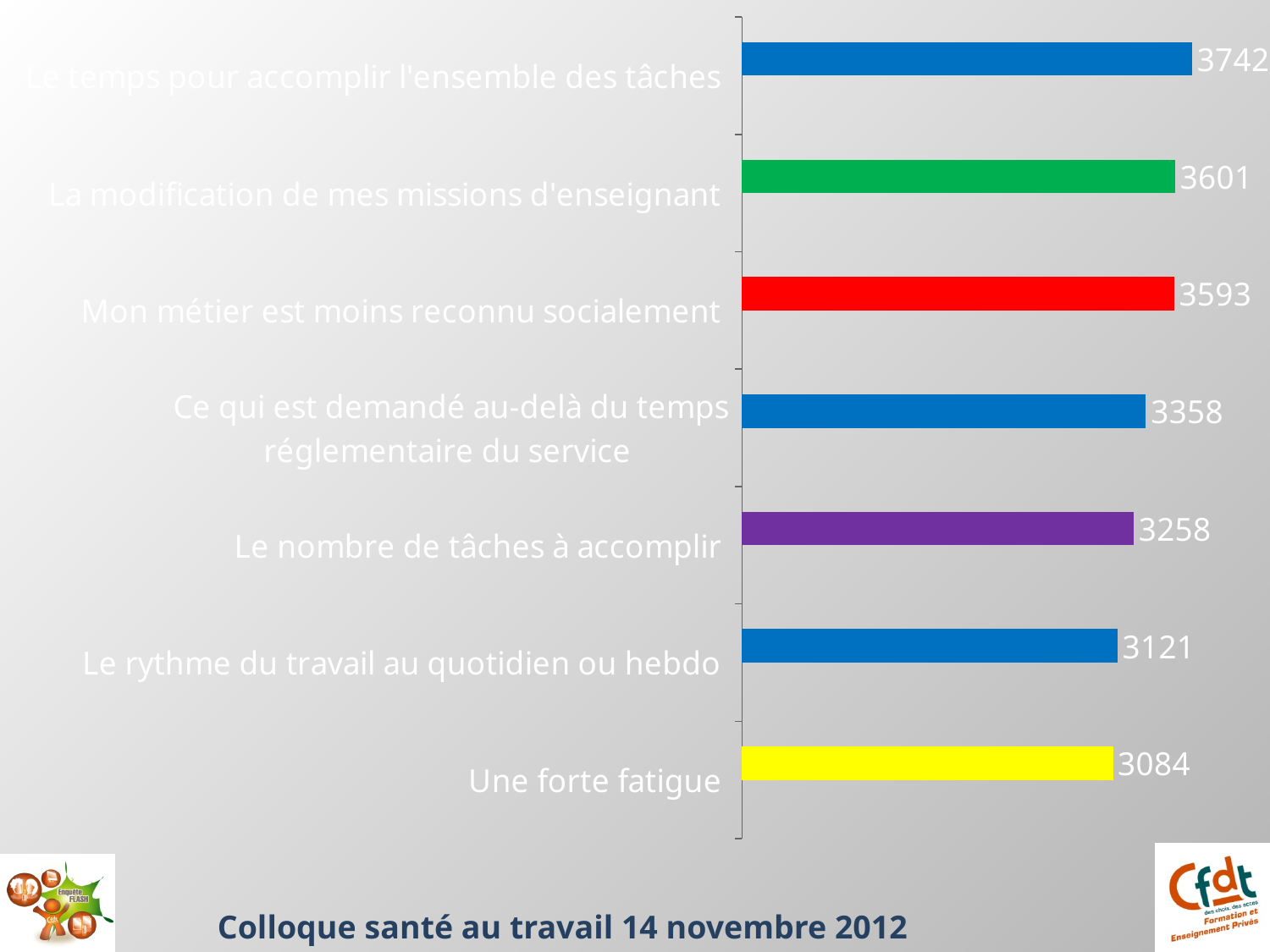
Which is larger: the value for "Ce qui est demandé au-delà du temps réglementaire du service" or the value for "Le nombre de tâches à accomplir"? Ce qui est demandé au-delà du temps réglementaire du service What is the value for "Le rythme du travail au quotidien ou hebdo"? 3121 How many categories are shown in the chart? 7 What kind of chart is shown on the slide? Bar chart What is the value for "Une forte fatigue"? 3084 What is the value for "Le nombre de tâches à accomplir"? 3258 What is the value for "Mon métier est moins reconnu socialement"? 3593 What colour is the bar for "Une forte fatigue"? Yellow Which category has the lowest value? Une forte fatigue Which category has the highest value? Le temps pour accomplir l'ensemble des tâches What is the difference between the values for "La modification de mes missions d'enseignant" and "Mon métier est moins reconnu socialement"? 8 What is the difference between the values for "Le temps pour accomplir l'ensemble des tâches" and "Une forte fatigue"? 658